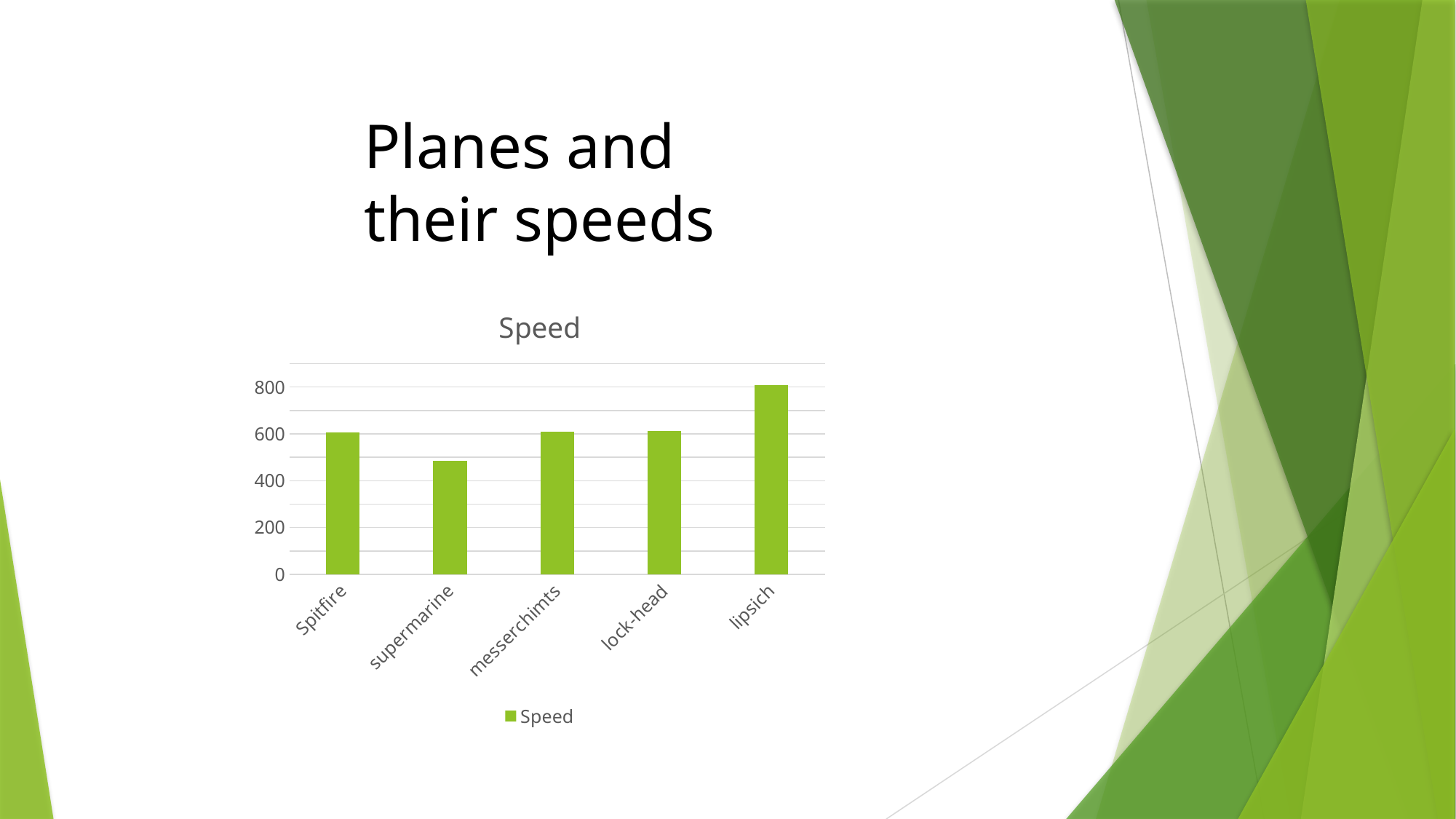
Which plane has the lowest speed? supermarine Which has the larger value, lock-head or supermarine? lock-head How many planes (categories) are plotted on the x axis? 5 Is the value for supermarine greater or less than 400? greater Which plane has the highest speed? lipsich What is the name of the series shown in the legend? Speed What kind of chart is shown on the slide? bar chart Is the value for supermarine greater or less than 600? less How many series does the legend list? 1 What is the title of the chart? Speed Which has the larger value, lipsich or supermarine? lipsich Is the value for lipsich greater or less than 600? greater